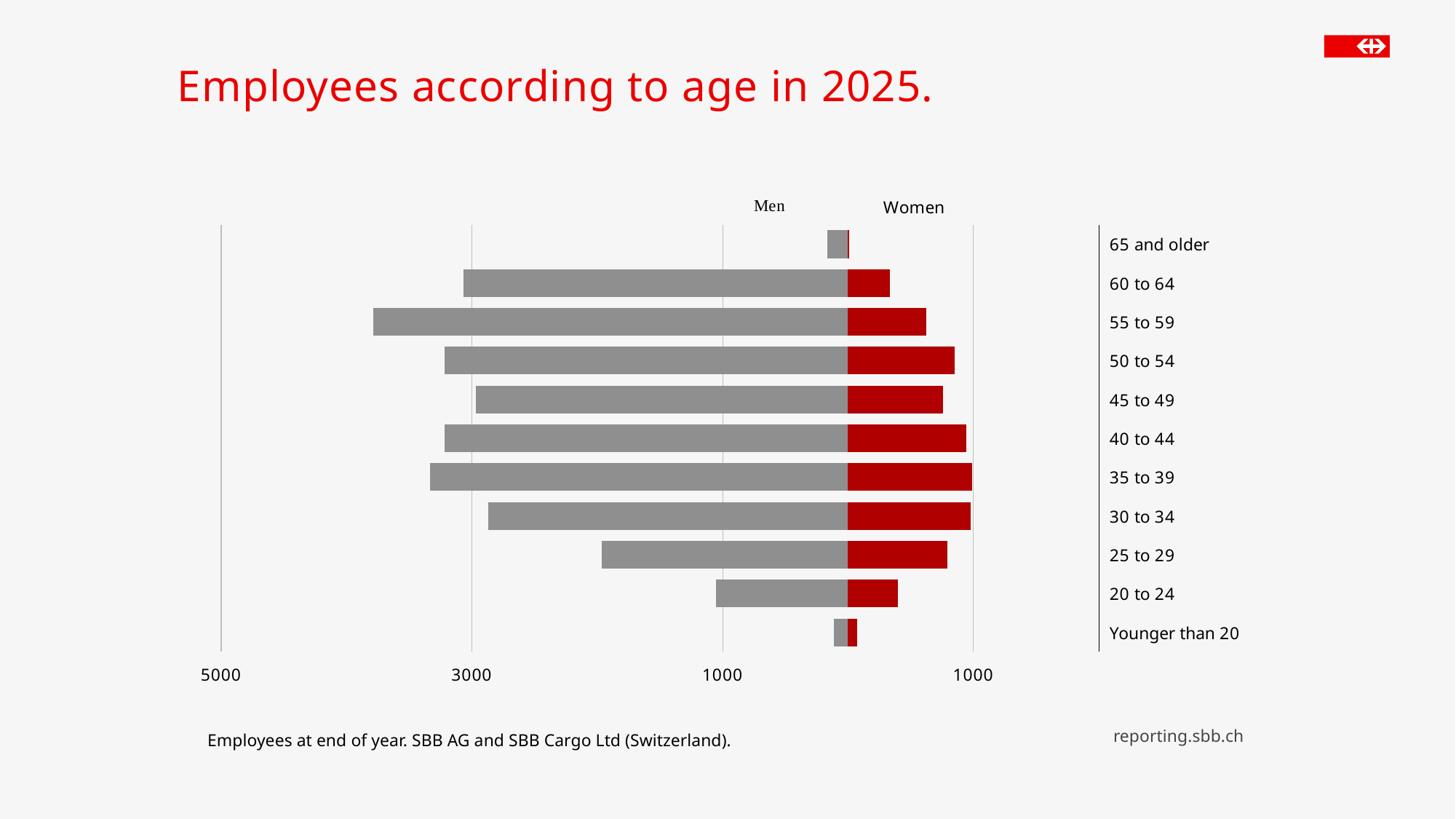
Is the number of women aged 60 to 64 greater or less than 1000? less How many age groups are shown in the chart? 11 What kind of chart is shown on the slide? bar chart How many series does the chart show? 2 In the 40 to 44 age group, are there more men or more women? Men What colour are the bars for women? red Which is larger, the number of women aged 50 to 54 or the number of women aged 60 to 64? 50 to 54 Is the number of men aged 25 to 29 greater or less than 1000? greater Which age group has the highest number of men? 55 to 59 Is the number of men aged 25 to 29 greater or less than 3000? less Which is larger, the number of men aged 55 to 59 or the number of men aged 60 to 64? 55 to 59